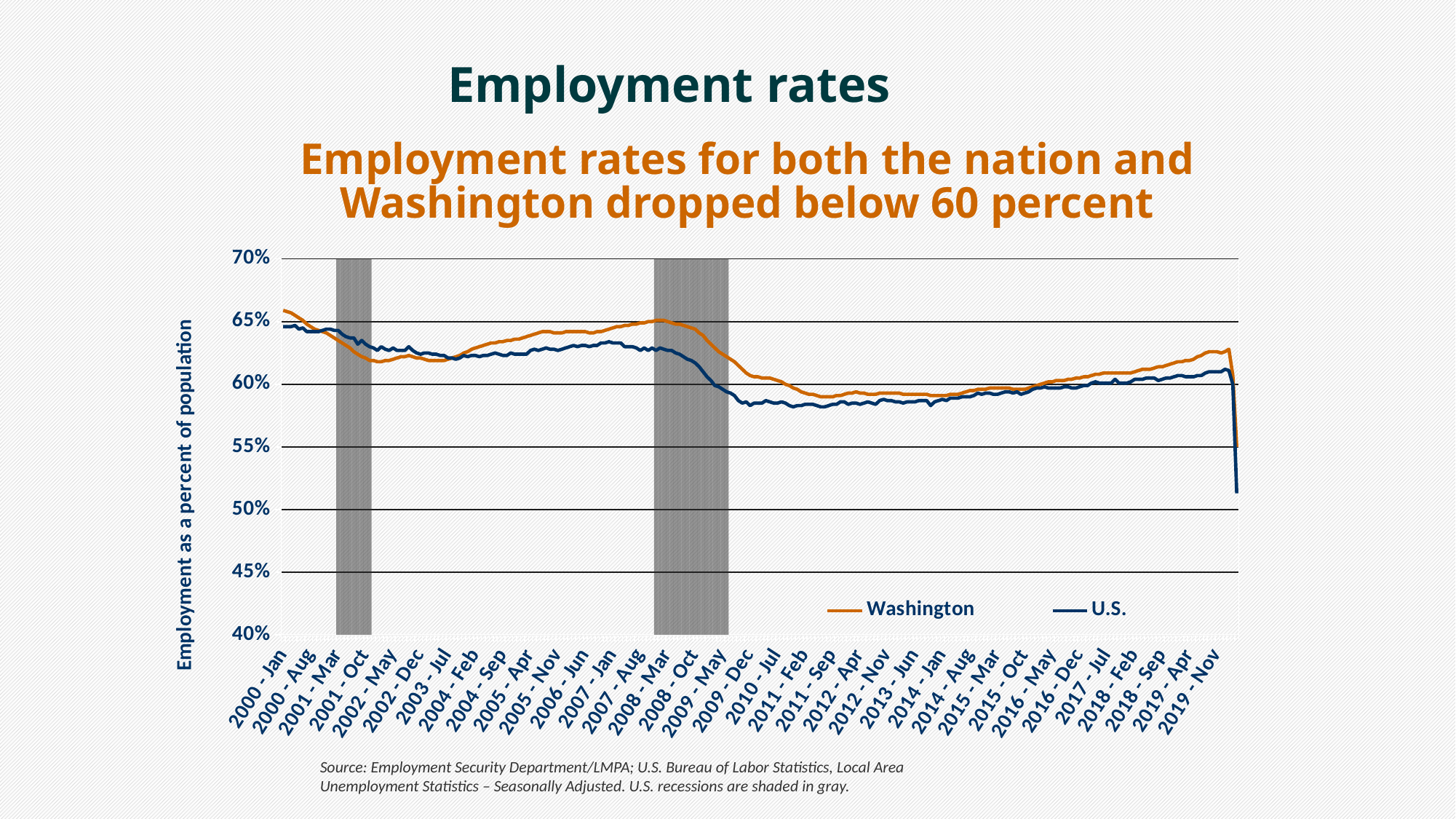
At 2019 - Apr, which series has the higher employment rate, Washington or U.S.? Washington Is the U.S. employment rate at 2009 - Dec greater or less than 60%? less Is the Washington employment rate at 2019 - Apr greater or less than 60%? greater What are the two series named in the legend? Washington and U.S. What kind of chart is shown on the slide? line chart Between 2008 - Mar and 2009 - Dec, does the Washington employment rate rise or fall? fall Is the Washington employment rate at 2000 - Jan greater or less than 65%? greater At 2005 - Nov, which series has the higher employment rate, Washington or U.S.? Washington How many series does the legend list? 2 What is the title of the vertical axis? Employment as a percent of population